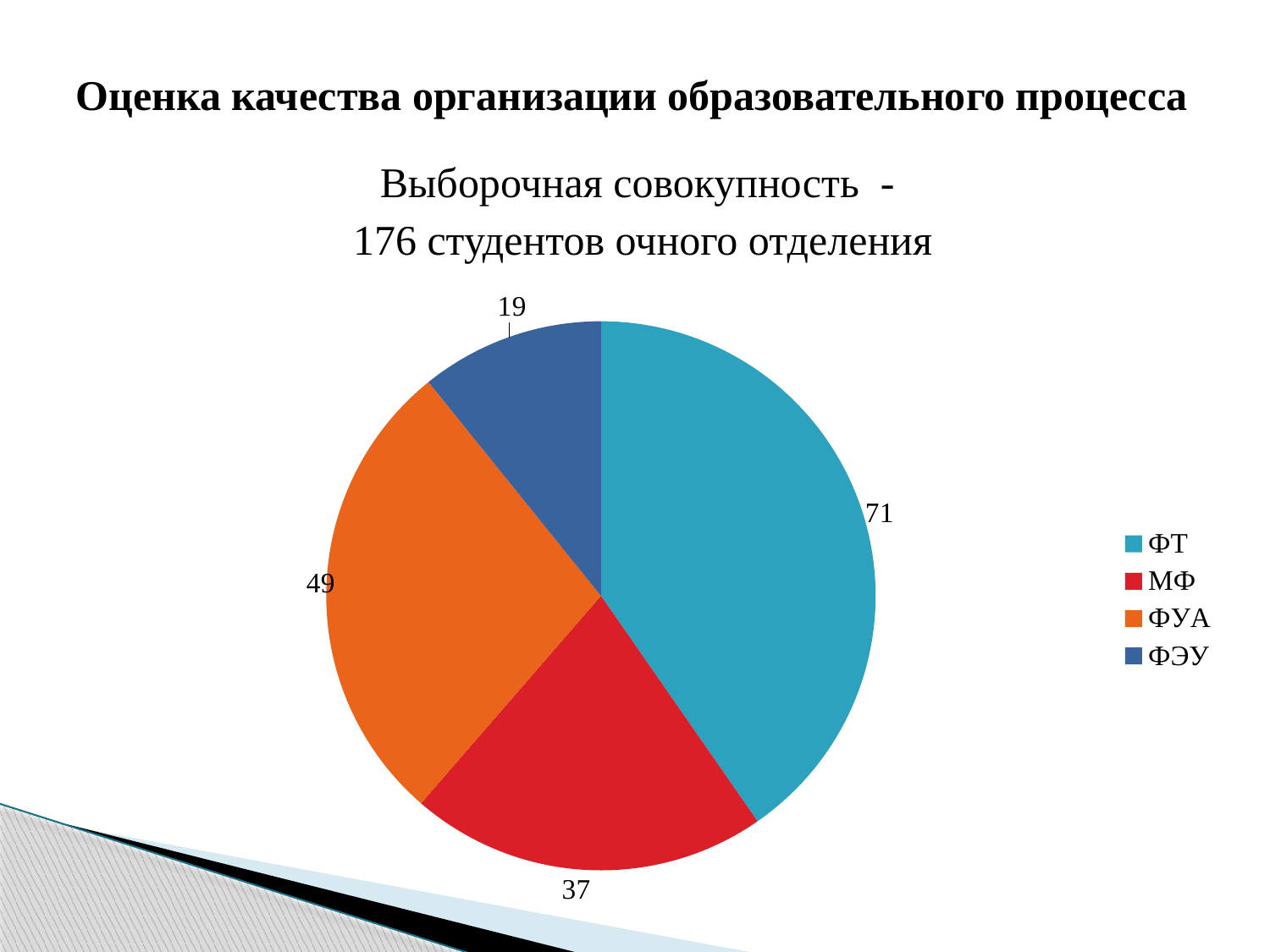
What is the total of all the slice values in the pie chart? 176 What type of chart is shown on the slide? Pie chart What colour is the slice for ФУА in the pie chart? Orange How many slices does the pie chart have? 4 Which is larger, the value for МФ or the value for ФУА? ФУА What value is shown for ФЭУ in the pie chart? 19 What value is shown for ФУА in the pie chart? 49 What is the difference between the values for ФТ and ФУА? 22 Which category has the largest slice of the pie chart? ФТ Which category has the smallest slice of the pie chart? ФЭУ What value is shown for МФ in the pie chart? 37 What value is shown for ФТ in the pie chart? 71